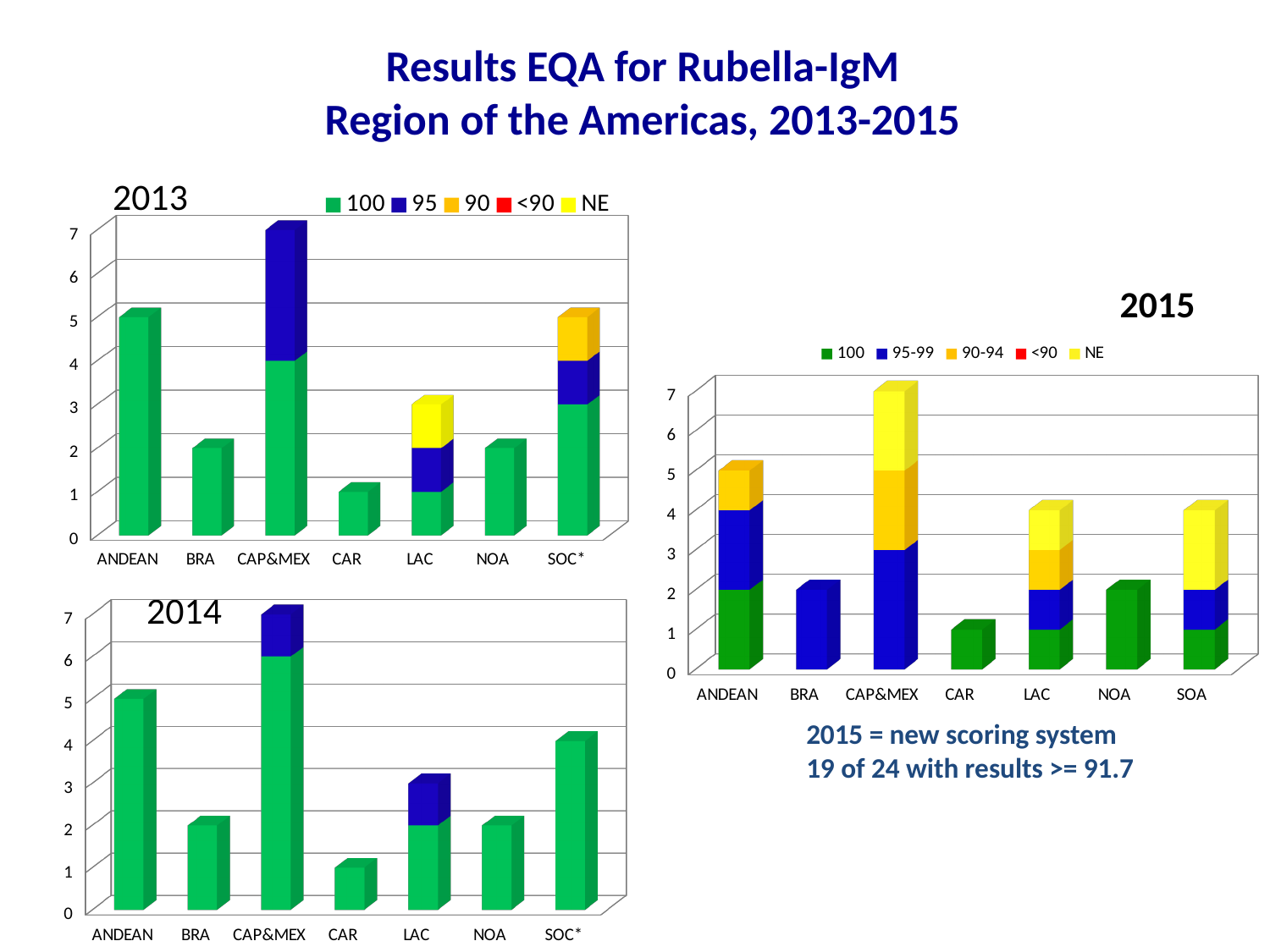
In the 2015 chart, is the bar for LAC or the bar for NOA taller? LAC In the 2014 chart, what is the difference between the CAP&MEX bar and the ANDEAN bar? 2 Which legend entry in the 2015 chart is shown in yellow? NE What kind of chart is the 2013 chart? bar chart In the 2013 chart, what is the value for ANDEAN? 5 How many categories are shown on the x axis of the 2014 chart? 7 In the 2015 chart, what is the total height of the CAP&MEX bar? 7 How many series does the legend of the 2015 chart list? 5 In the 2015 chart, is the value for ANDEAN greater or less than 4? greater In the 2013 chart, which category has the tallest bar? CAP&MEX In the 2014 chart, what is the value for SOC*? 4 In the 2014 chart, which category has the shortest bar? CAR